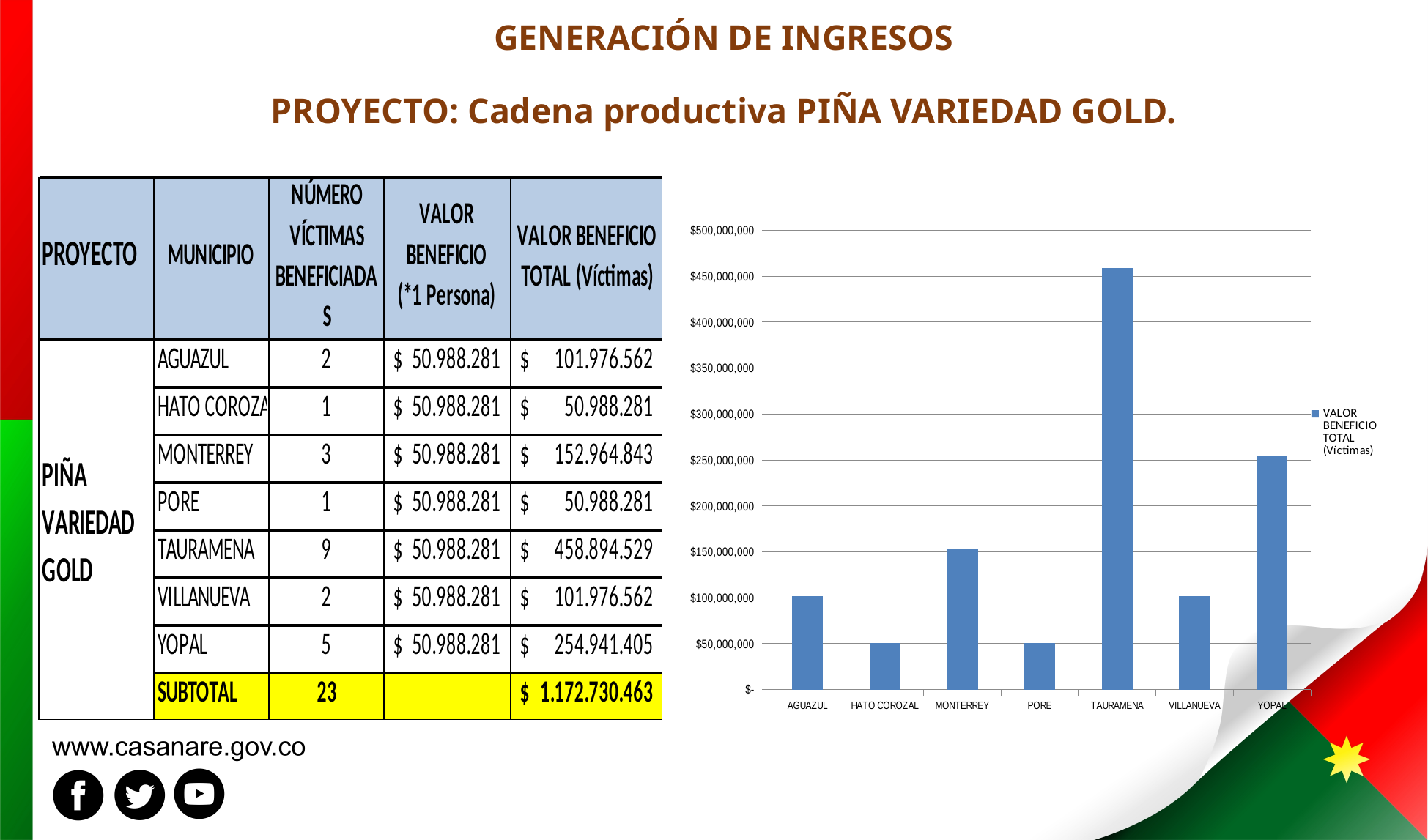
Which is larger in the chart, the bar for YOPAL or the bar for MONTERREY? YOPAL Is the value for YOPAL greater or less than $200,000,000? greater Is the value for MONTERREY greater or less than $100,000,000? greater What is the legend entry of the chart? VALOR BENEFICIO TOTAL (Víctimas) According to the table on the slide, what is the VALOR BENEFICIO TOTAL for YOPAL plotted in the chart? $ 254.941.405 According to the table on the slide, what is the VALOR BENEFICIO TOTAL for TAURAMENA plotted in the chart? $ 458.894.529 Which municipality has the highest bar in the chart? TAURAMENA Is the value for HATO COROZAL greater or less than $100,000,000? less What kind of chart is shown on the right of the slide? bar chart How many municipalities are shown on the x axis of the chart? 7 How many series does the chart legend list? 1